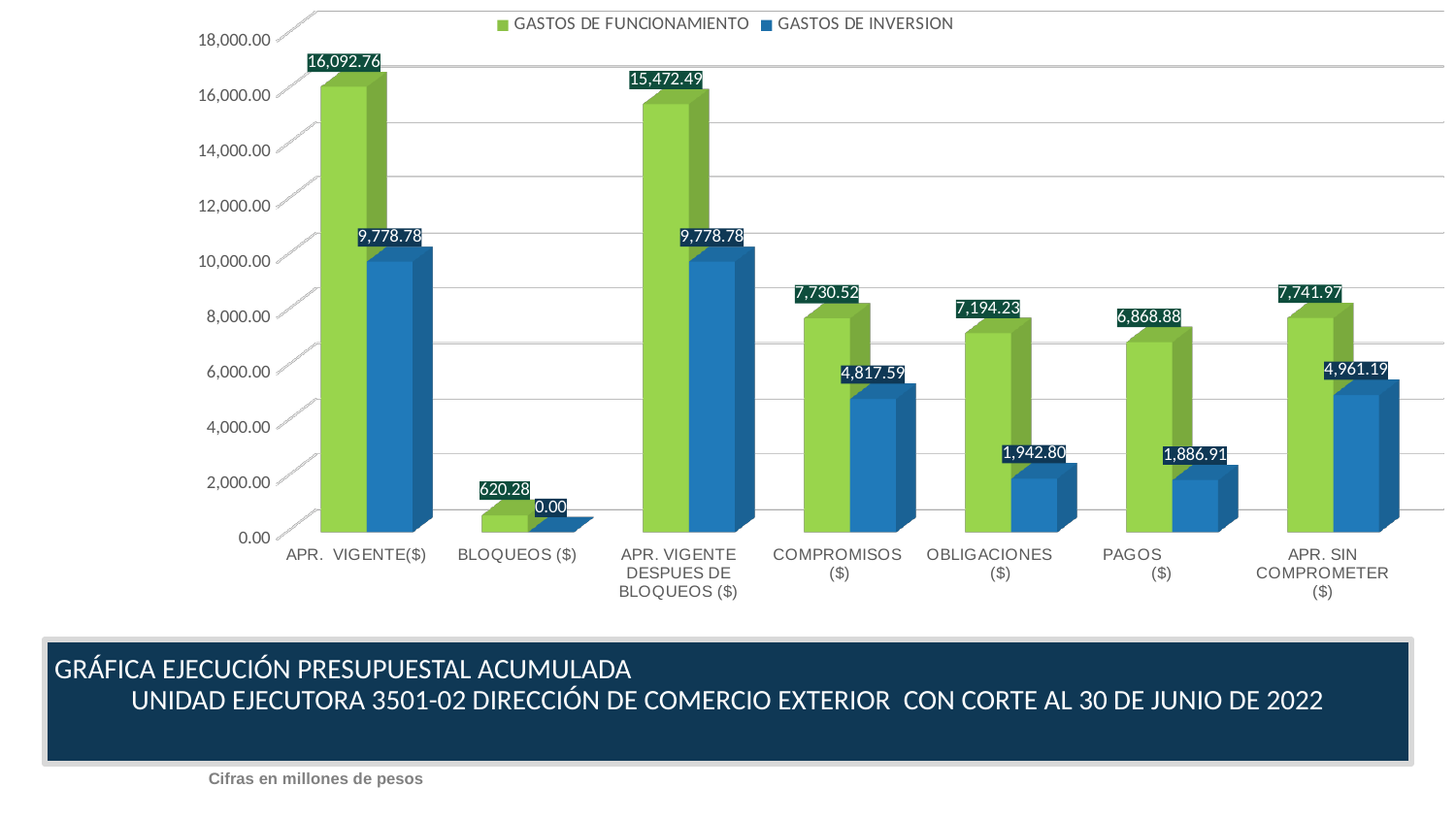
Which category has the lowest GASTOS DE INVERSION value? BLOQUEOS ($) What is the value of GASTOS DE FUNCIONAMIENTO for APR. VIGENTE($)? 16,092.76 What is the difference between GASTOS DE FUNCIONAMIENTO for APR. VIGENTE($) and for APR. VIGENTE DESPUES DE BLOQUEOS ($)? 620.27 What is the value of GASTOS DE INVERSION for BLOQUEOS ($)? 0.00 How many categories are shown on the x axis? 7 What is the value of GASTOS DE INVERSION for COMPROMISOS ($)? 4,817.59 Which is larger: GASTOS DE INVERSION for OBLIGACIONES ($) or for APR. SIN COMPROMETER ($)? APR. SIN COMPROMETER ($) What kind of chart is shown on the slide? Bar chart How many series does the legend list? 2 Which category has the highest GASTOS DE FUNCIONAMIENTO value? APR. VIGENTE($) What is the difference between GASTOS DE FUNCIONAMIENTO and GASTOS DE INVERSION for COMPROMISOS ($)? 2,912.93 What is the value of GASTOS DE FUNCIONAMIENTO for PAGOS ($)? 6,868.88